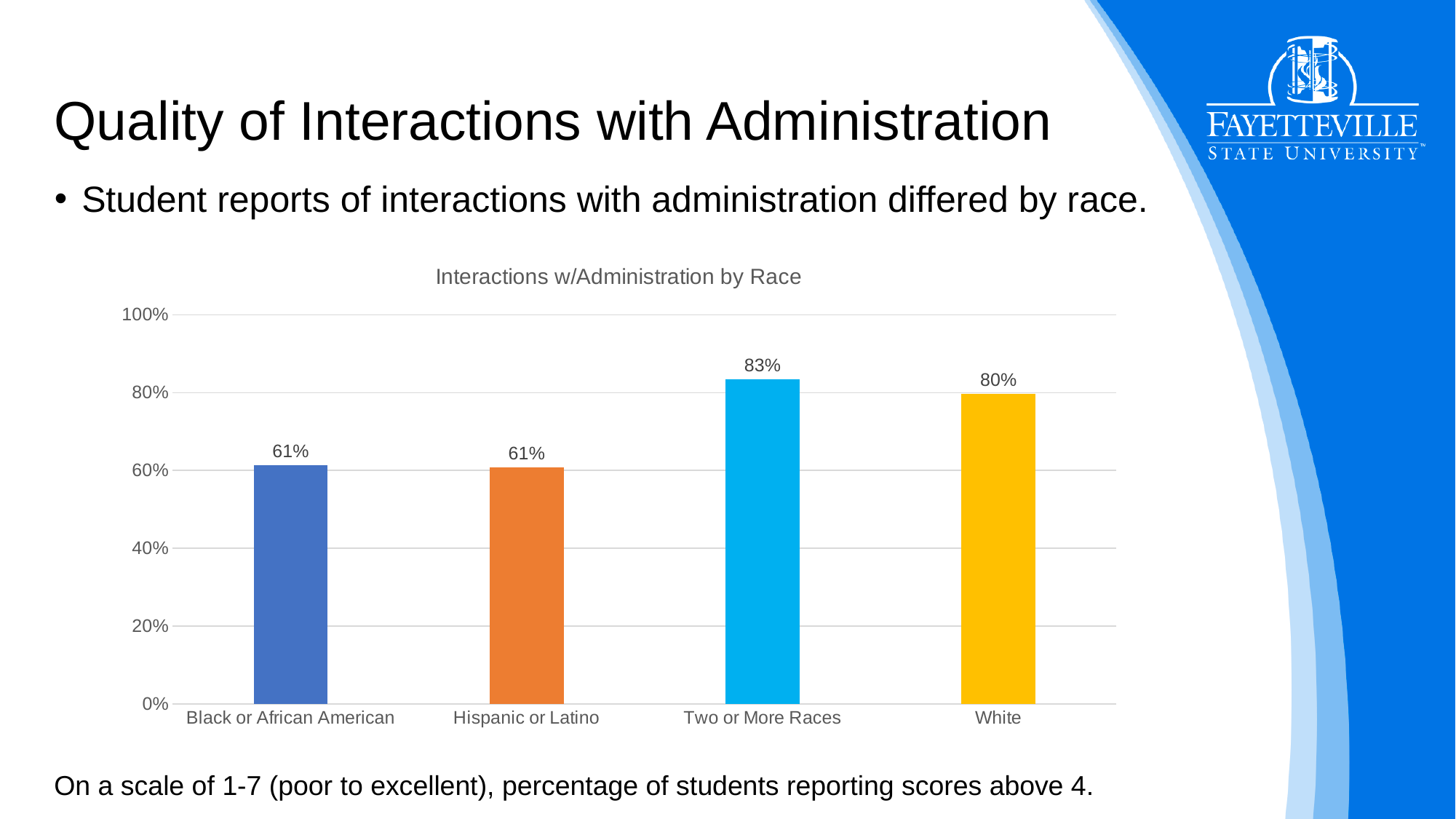
What is the value for Two or More Races? 83% What is the value for White? 80% Is the value for White greater or less than 60%? greater What is the value for Black or African American? 61% What is the value for Hispanic or Latino? 61% Which category has the highest value? Two or More Races What kind of chart is shown on the slide? Bar chart What is the title of the chart? Interactions w/Administration by Race How many categories are shown on the x axis? 4 What is the difference between the values for Two or More Races and White? 3% What is the difference between the values for White and Hispanic or Latino? 19% Which is larger, the value for Two or More Races or the value for Black or African American? Two or More Races